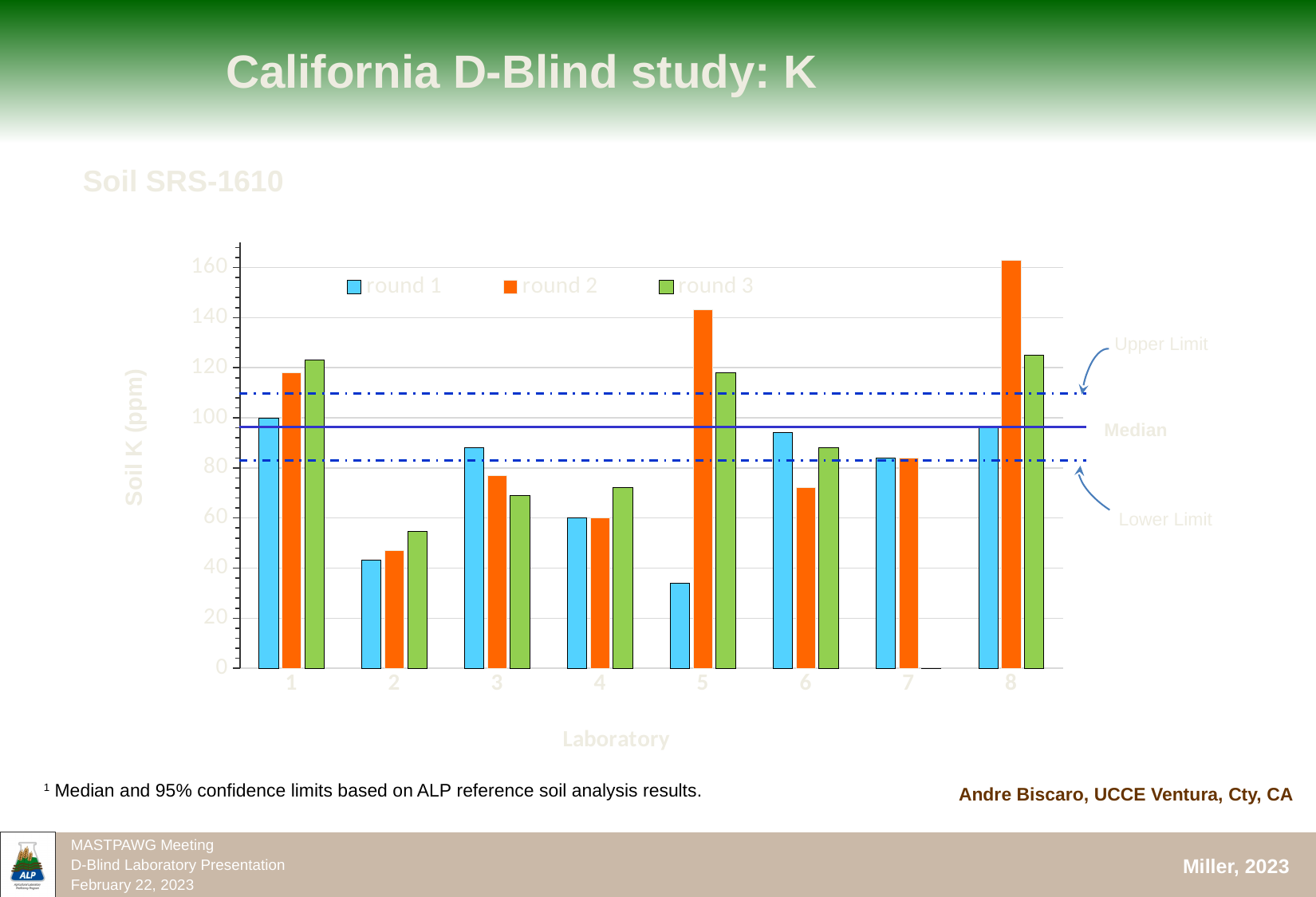
Is the round 3 value for laboratory 1 greater or less than 120? greater What is the label of the y axis of the chart? Soil K (ppm) How many laboratories are shown on the x axis of the chart? 8 For laboratory 3, which is larger: the round 1 value or the round 3 value? round 1 Which laboratory has the highest round 2 value? 8 Is the round 2 value for laboratory 5 greater or less than 140? greater Which laboratory has the lowest round 1 value? 5 Is the round 1 value for laboratory 2 greater or less than 60? less For laboratory 5, which is larger: the round 1 value or the round 2 value? round 2 What kind of chart is shown on the slide? bar chart How many series does the chart legend list? 3